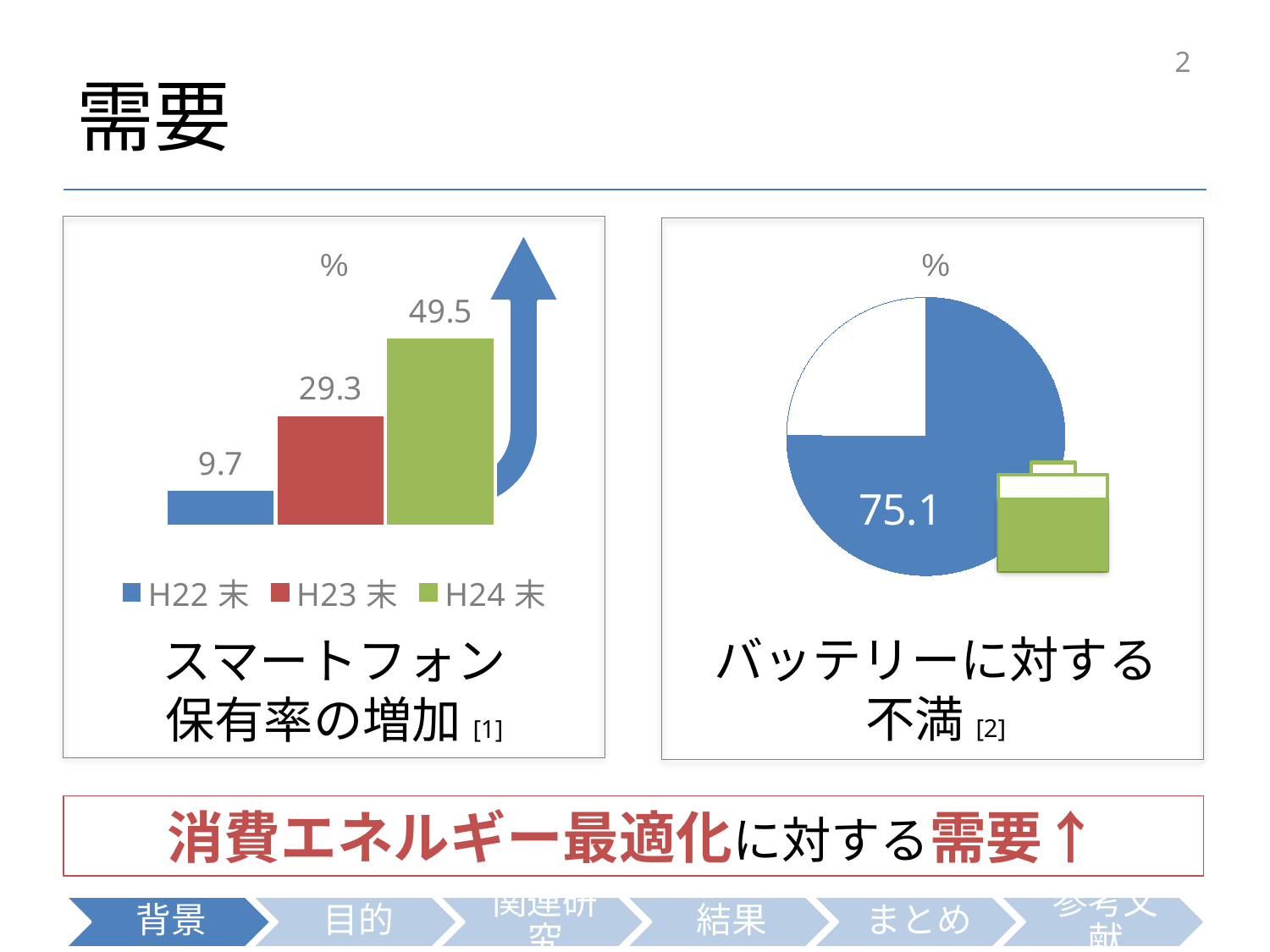
In the left chart (スマートフォン保有率の増加), what is the difference between the H24 末 and H22 末 values? 39.8 In the left chart (スマートフォン保有率の増加), what is the value for H24 末? 49.5 In the left chart (スマートフォン保有率の増加), what is the value for H22 末? 9.7 What kind of chart is the right chart (バッテリーに対する不満)? pie chart What kind of chart is the left chart (スマートフォン保有率の増加)? bar chart In the left chart (スマートフォン保有率の増加), which period has the lowest value? H22 末 In the left chart (スマートフォン保有率の増加), which period has the highest value? H24 末 In the left chart (スマートフォン保有率の増加), which is larger, the value for H23 末 or H22 末? H23 末 In the left chart (スマートフォン保有率の増加), do the values rise or fall from H22 末 to H24 末? rise In the right chart (バッテリーに対する不満), what value is labelled on the blue slice? 75.1 In the left chart (スマートフォン保有率の増加), how many entries does the legend list? 3 In the left chart (スマートフォン保有率の増加), what is the value for H23 末? 29.3